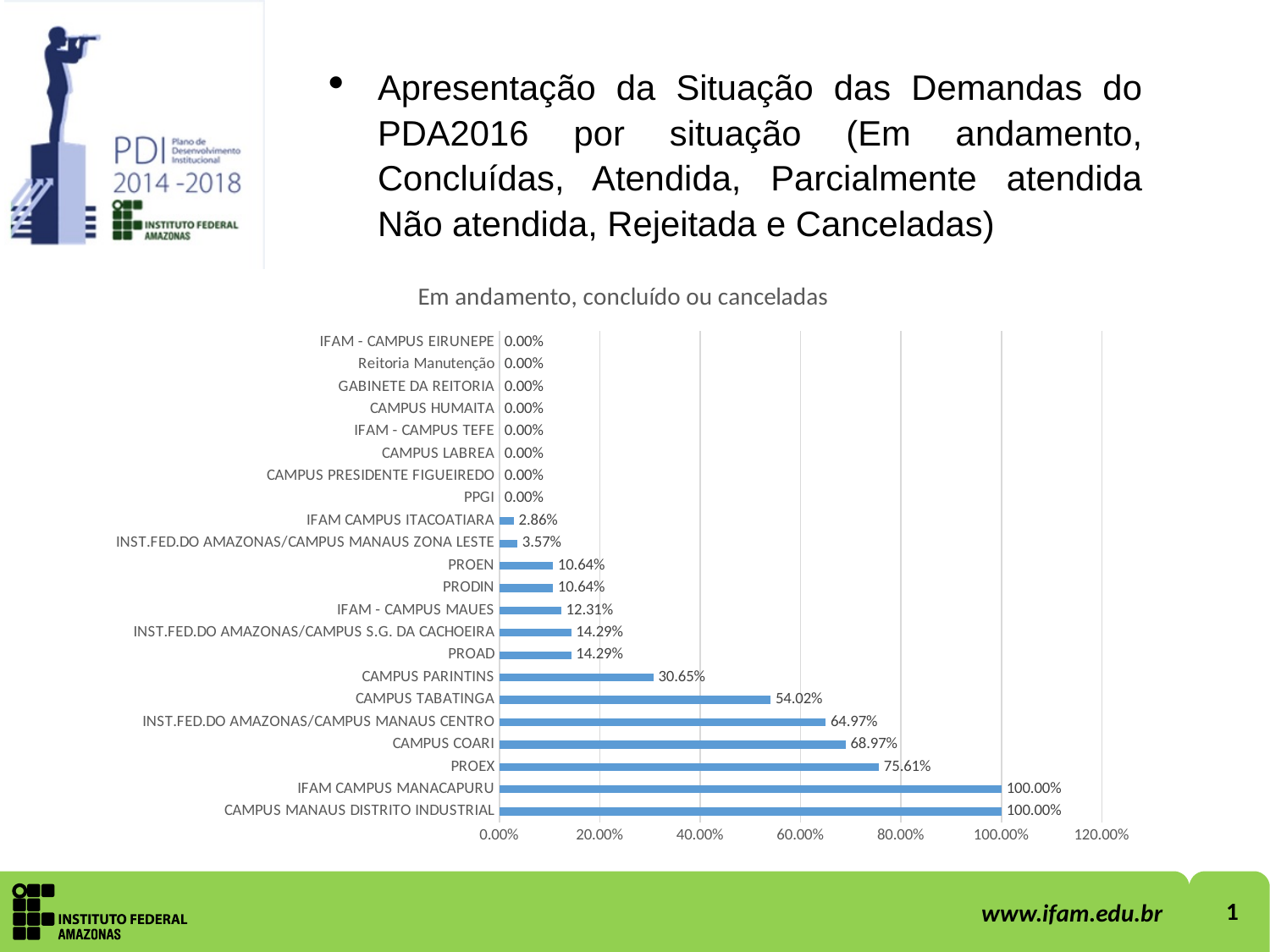
What is the value for PPGI? 0.00% What is the difference between the values for PROEX and CAMPUS PARINTINS? 44.96% What is the difference between the values for CAMPUS COARI and CAMPUS TABATINGA? 14.95% Which is larger, the value for IFAM - CAMPUS MAUES or the value for PROAD? PROAD What is the title of the chart? Em andamento, concluído ou canceladas Is the value for INST.FED.DO AMAZONAS/CAMPUS MANAUS CENTRO greater or less than 60.00%? greater How many categories are shown in the chart? 22 What is the value for IFAM CAMPUS ITACOATIARA? 2.86% What is the value for PROEX? 75.61% What kind of chart is shown on the slide? bar chart What is the value for CAMPUS COARI? 68.97% What is the value for CAMPUS PARINTINS? 30.65%